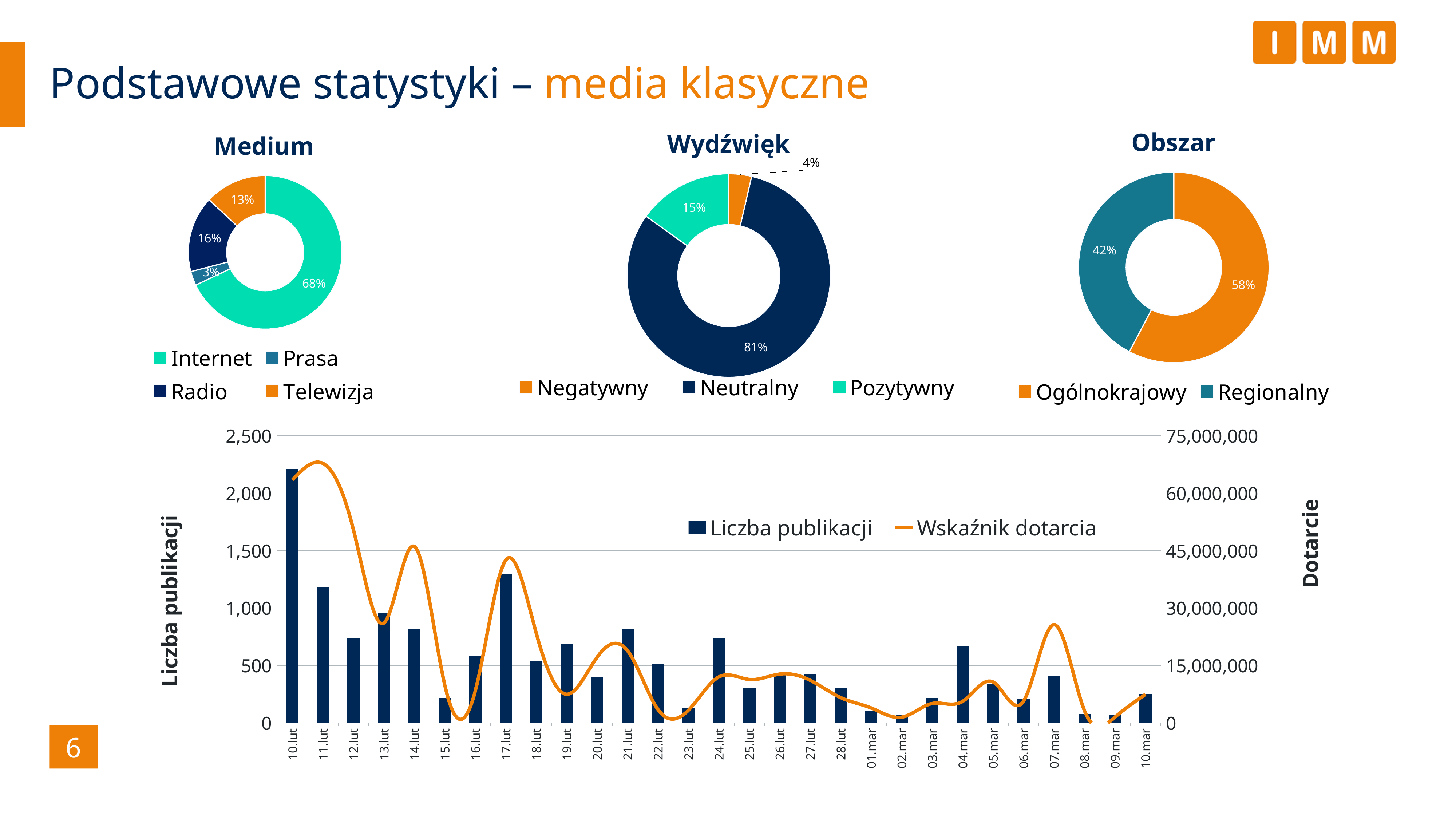
In the Obszar chart, which category has the largest share? Ogólnokrajowy In the Obszar chart, what share is Regionalny? 42% What kind of chart is the Obszar chart? Donut chart How many categories does the legend of the Wydźwięk chart list? 3 In the bottom chart, which date has the highest Liczba publikacji bar? 10.lut How many series does the legend of the bottom chart list? 2 In the bottom chart, is the Liczba publikacji value for 15.lut greater or less than 500? less In the Medium chart, what is the difference between the Radio and Telewizja shares? 3% In the Wydźwięk chart, what share is Neutralny? 81% In the Wydźwięk chart, which is larger, Negatywny or Pozytywny? Pozytywny In the Medium chart, which category has the smallest share? Prasa In the Medium chart, what share does Internet have? 68%